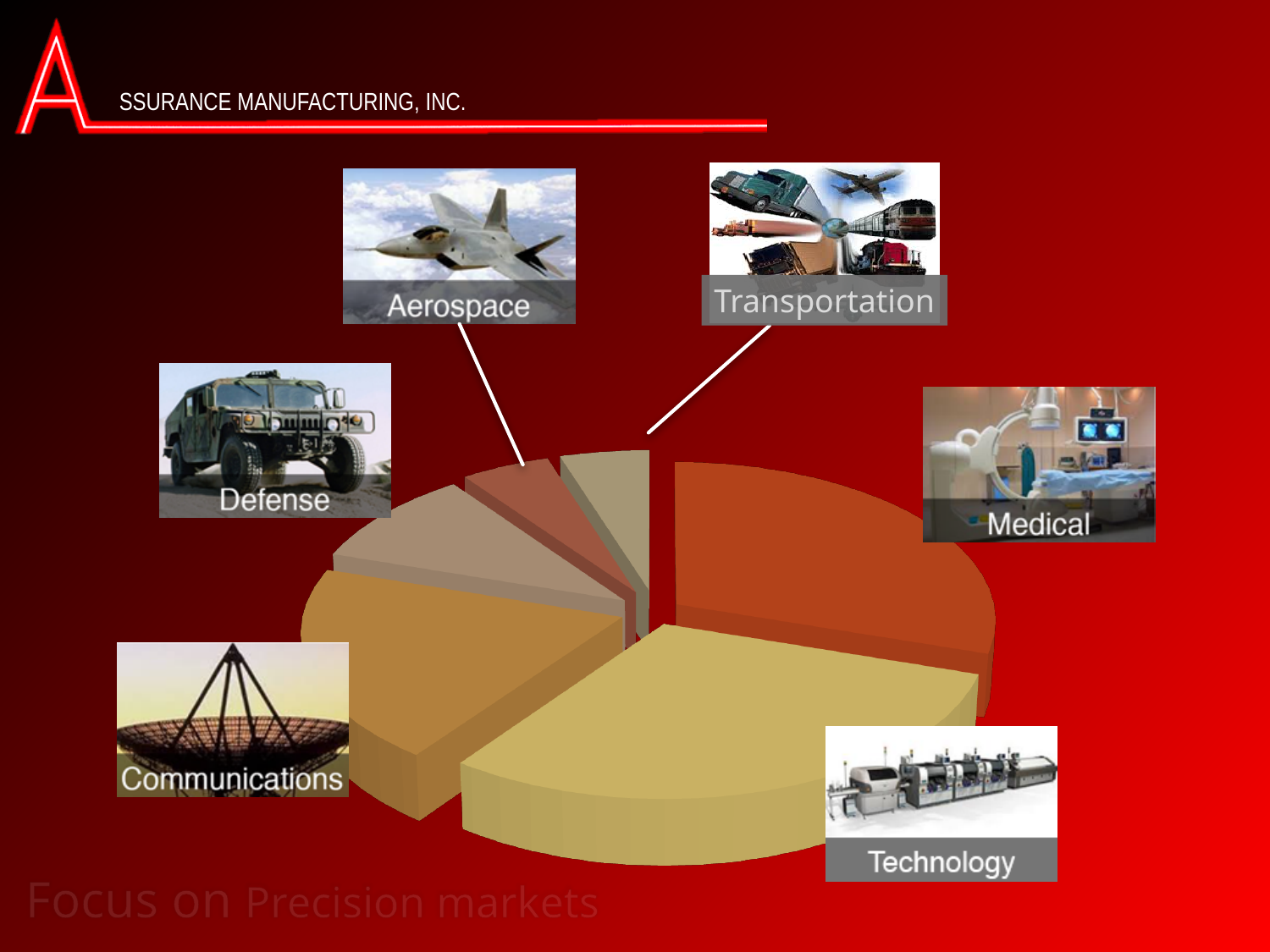
Which is larger in the pie chart, the Medical slice or the Aerospace slice? Medical What caption appears at the bottom of the slide beneath the pie chart? Focus on Precision markets What kind of chart is shown on the slide? pie chart Which is larger in the pie chart, the Defense slice or the Aerospace slice? Defense Which is larger in the pie chart, the Medical slice or the Communications slice? Medical How many slices does the pie chart have? 6 Which market segments are labelled around the pie chart? Aerospace, Transportation, Medical, Technology, Communications, Defense